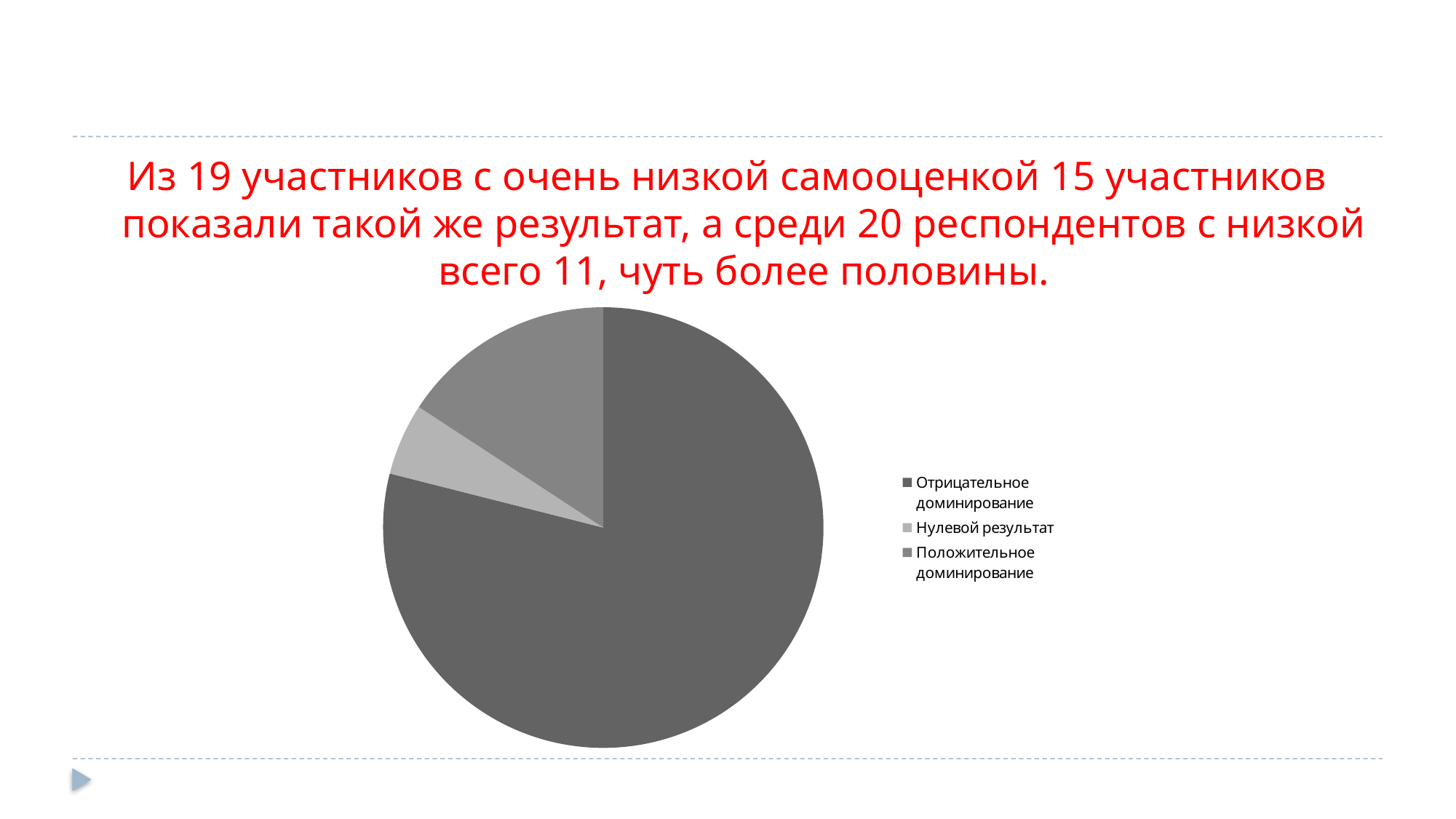
Does the slice for Отрицательное доминирование take up more or less than half of the pie? more Which category has the smallest slice in the pie chart? Нулевой результат Which slice is larger: Отрицательное доминирование or Положительное доминирование? Отрицательное доминирование Which category has the largest slice in the pie chart? Отрицательное доминирование Which legend entry is listed first in the pie chart's legend? Отрицательное доминирование Which slice is larger: Положительное доминирование or Нулевой результат? Положительное доминирование What kind of chart is shown on the slide? pie chart How many slices does the pie chart have? 3 How many entries does the legend of the pie chart list? 3 Which legend entry is shown in the lightest shade of grey? Нулевой результат